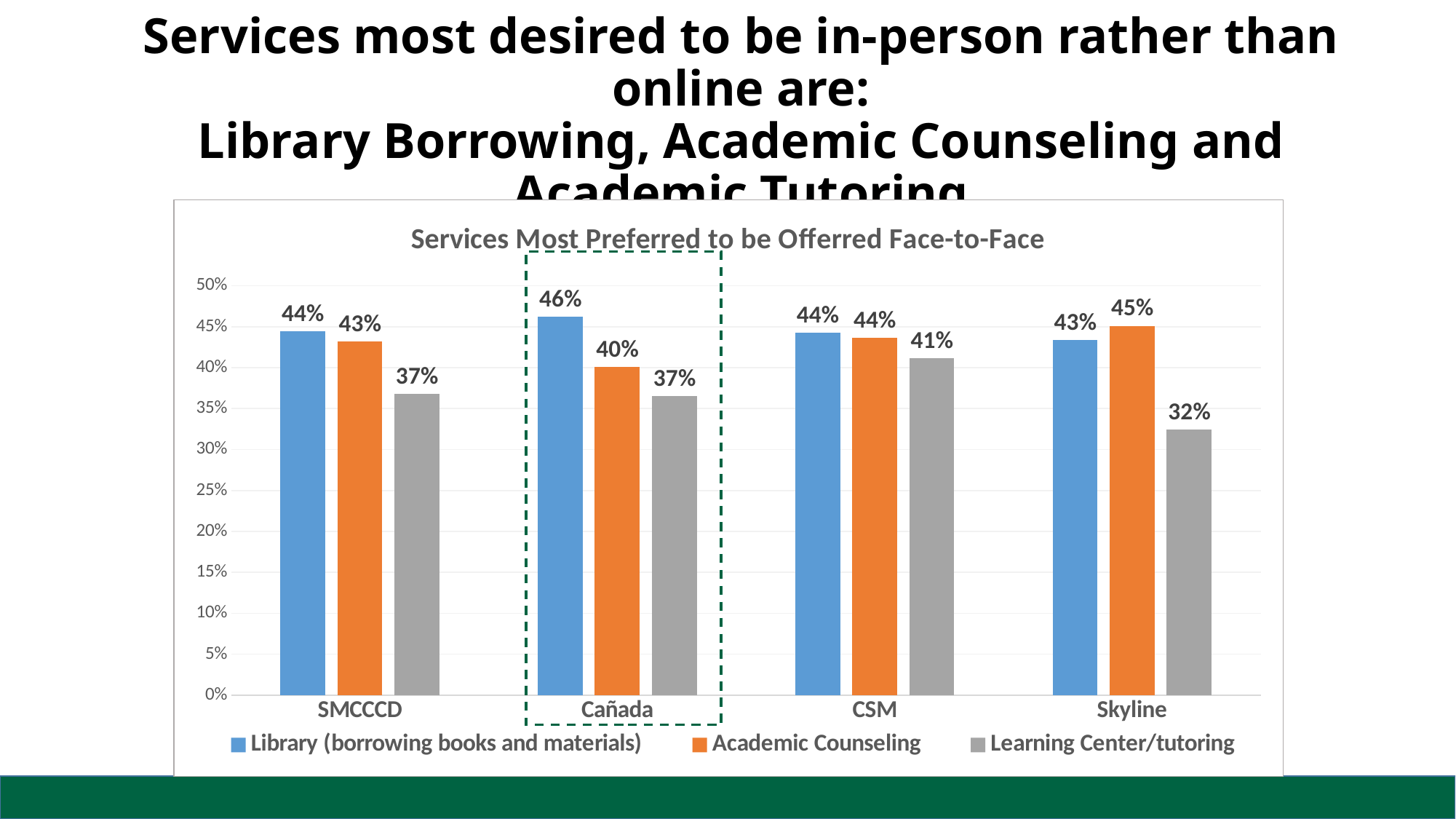
What is the title of the chart? Services Most Preferred to be Offerred Face-to-Face What is the value for Learning Center/tutoring at Skyline? 32% Is the value for Learning Center/tutoring at CSM greater or less than 35%? greater What is the value for Academic Counseling at CSM? 44% How many colleges/categories are shown on the x axis? 4 Which college has the lowest value for Learning Center/tutoring? Skyline Which is larger at Skyline: Academic Counseling or Library (borrowing books and materials)? Academic Counseling What kind of chart is shown? Bar chart What is the value for Library (borrowing books and materials) at Cañada? 46% Which college has the highest value for Library (borrowing books and materials)? Cañada What is the difference between the Library and Learning Center/tutoring values at Skyline? 11% How many series does the legend list? 3